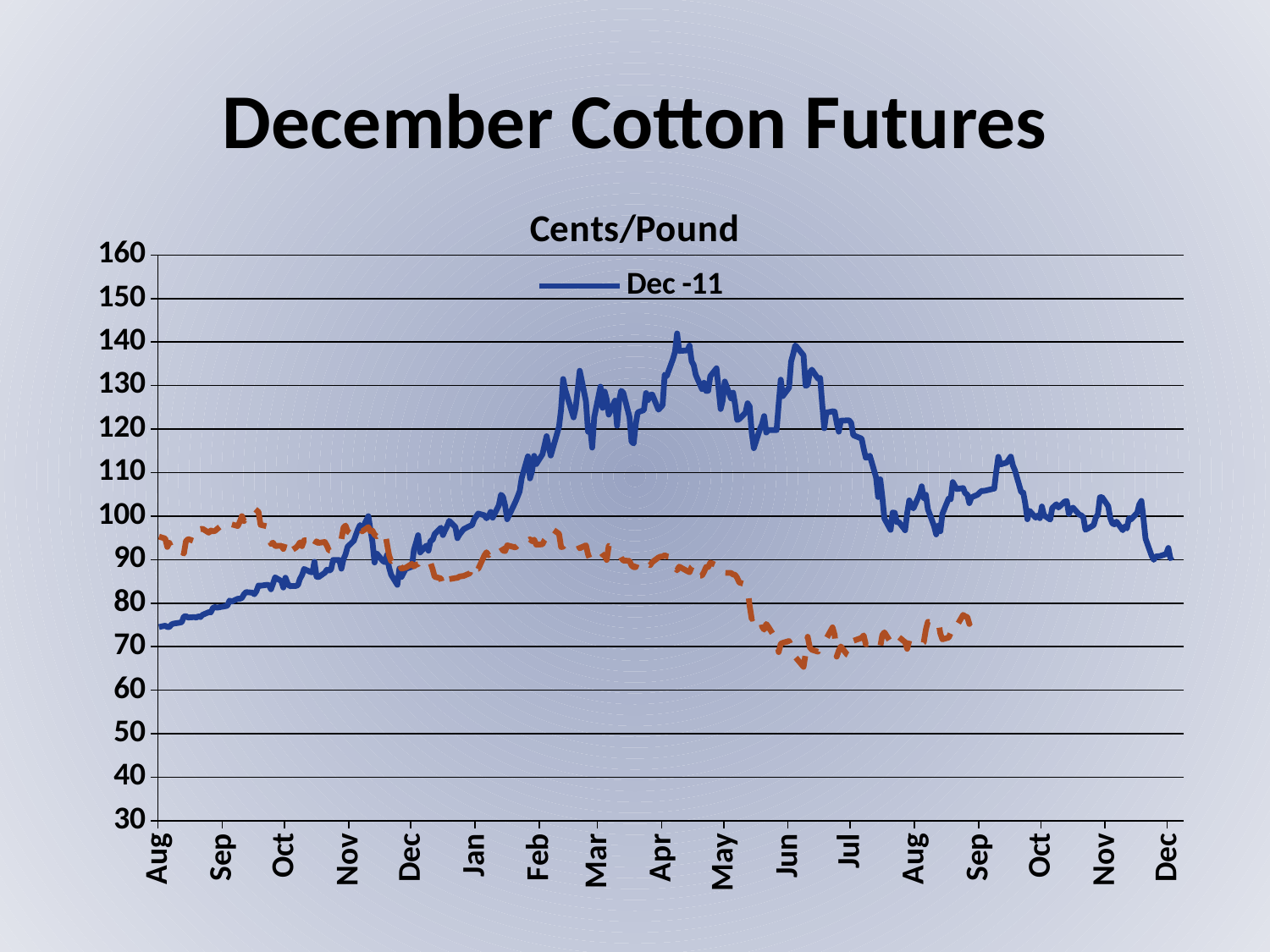
What series name is shown in the chart legend? Dec -11 Does the Dec -11 line generally rise or fall from Apr to the final Dec? fall Is the dashed line's value around Jun greater or less than 80? less Is the Dec -11 value at the first Aug label greater or less than 80? less Is the Dec -11 value at the final Dec label greater or less than 100? less How many series does the legend list? 1 Around Jun, which line is higher, the solid Dec -11 line or the dashed line? Dec -11 What kind of chart is shown on the slide? line chart What is the title of the chart? Cents/Pound Does the Dec -11 line generally rise or fall from Aug to Feb? rise How many month labels are shown along the x axis? 17